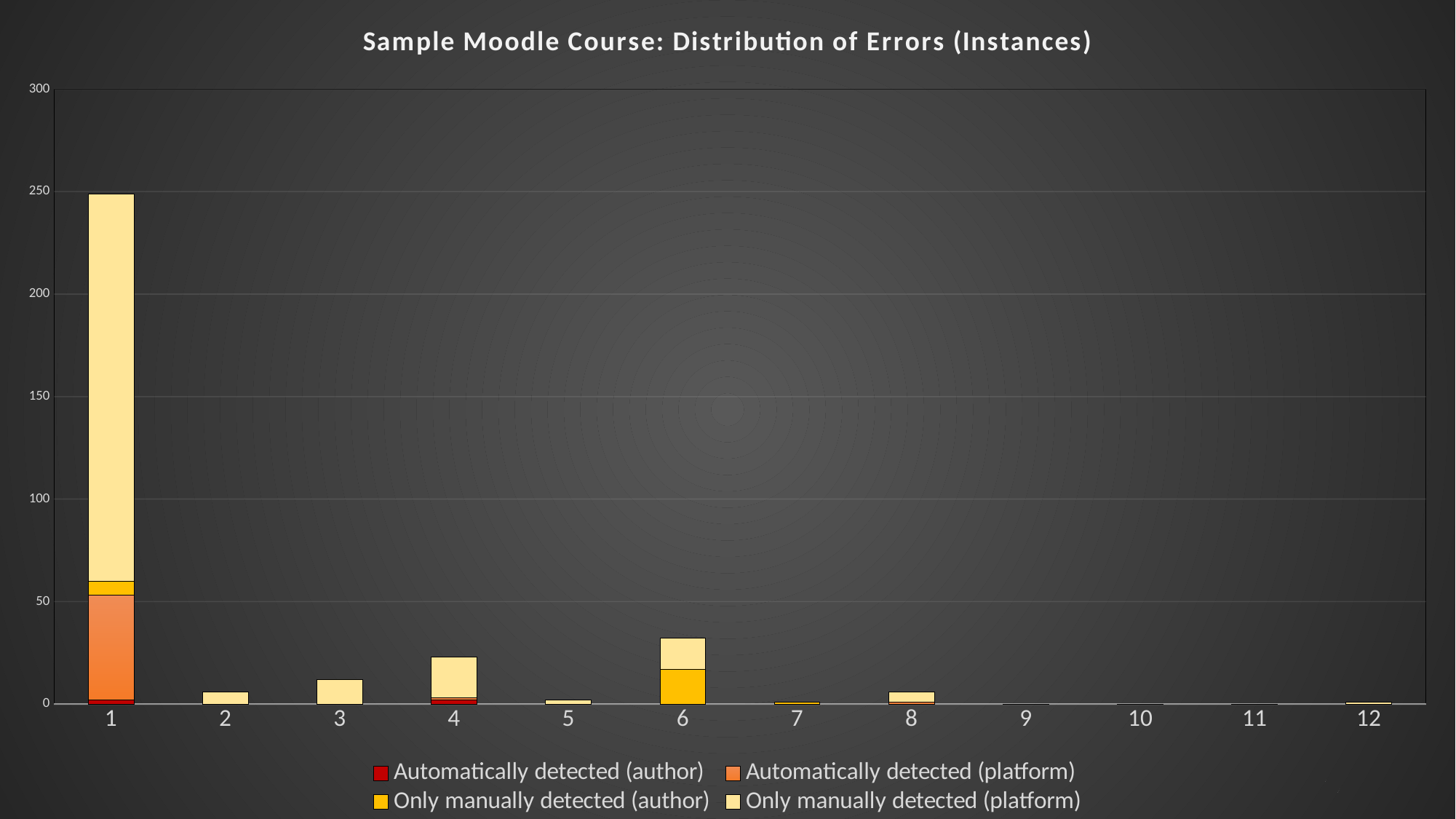
Which has the larger total bar, category 6 or category 4? 6 Is the total value for category 4 greater or less than 50? less What is the title of the chart? Sample Moodle Course: Distribution of Errors (Instances) What kind of chart is shown on the slide? Stacked bar chart Which legend entry is shown in red? Automatically detected (author) How many series does the legend list? 4 Which category has the highest total bar? 1 Is the total value for category 6 greater or less than 50? less Which has the larger total bar, category 2 or category 6? 6 Which has the larger total bar, category 3 or category 4? 4 Is the total value for category 1 greater or less than 200? greater How many categories are shown on the x axis? 12